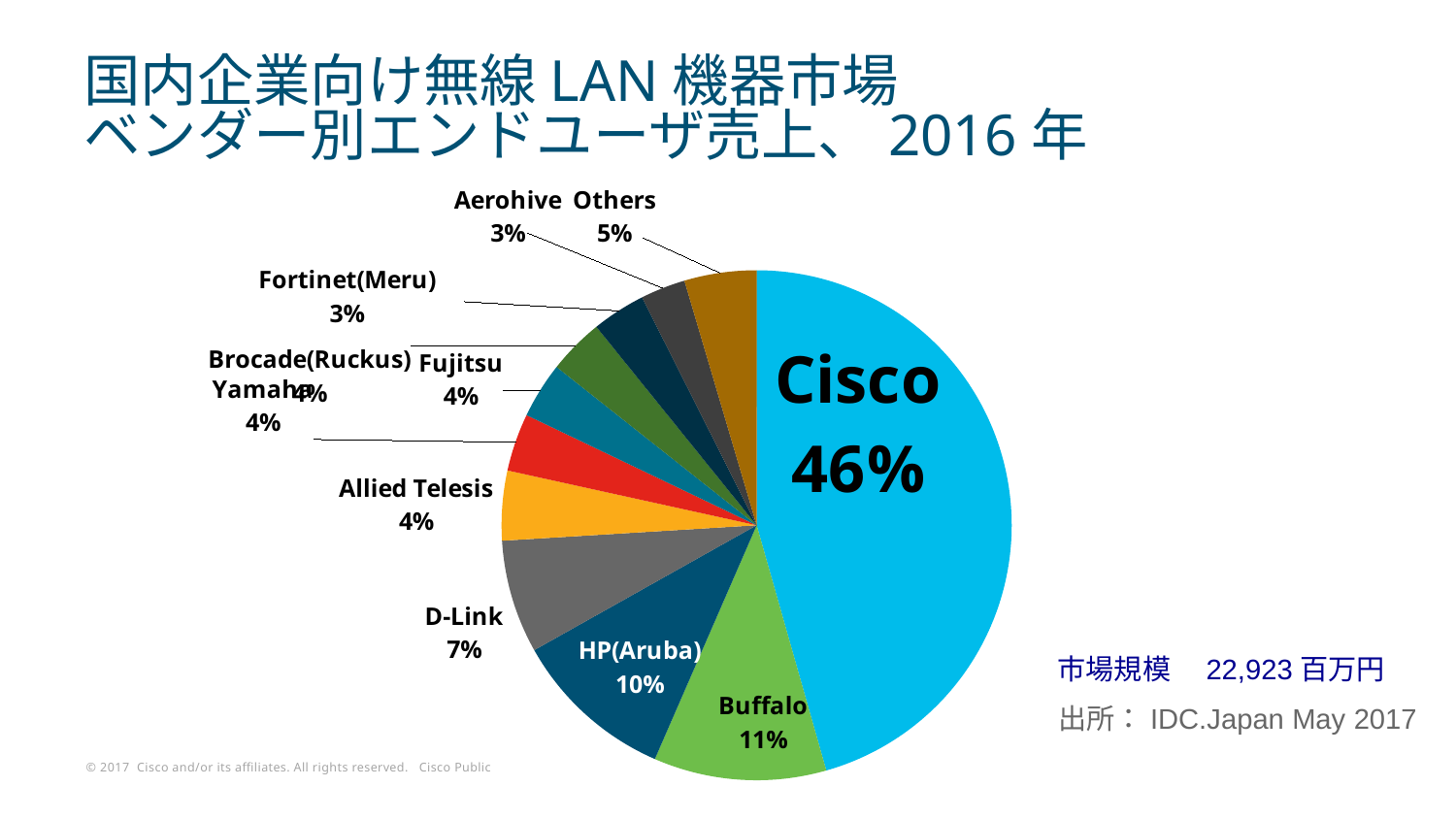
What is the difference in percentage points between D-Link and Allied Telesis? 3 What percentage is shown for HP(Aruba)? 10% How many slices does the pie chart have? 11 What percentage is shown for Fortinet(Meru)? 3% What percentage is shown for D-Link? 7% What percentage is shown for Buffalo? 11% What kind of chart is shown on the slide? Pie chart What is the difference in percentage points between Cisco's share and Buffalo's share? 35 What share of the pie does Cisco hold? 46% Which vendor has the largest slice of the pie? Cisco What percentage is shown for Others? 5% Which vendor has a larger share, Buffalo or HP(Aruba)? Buffalo